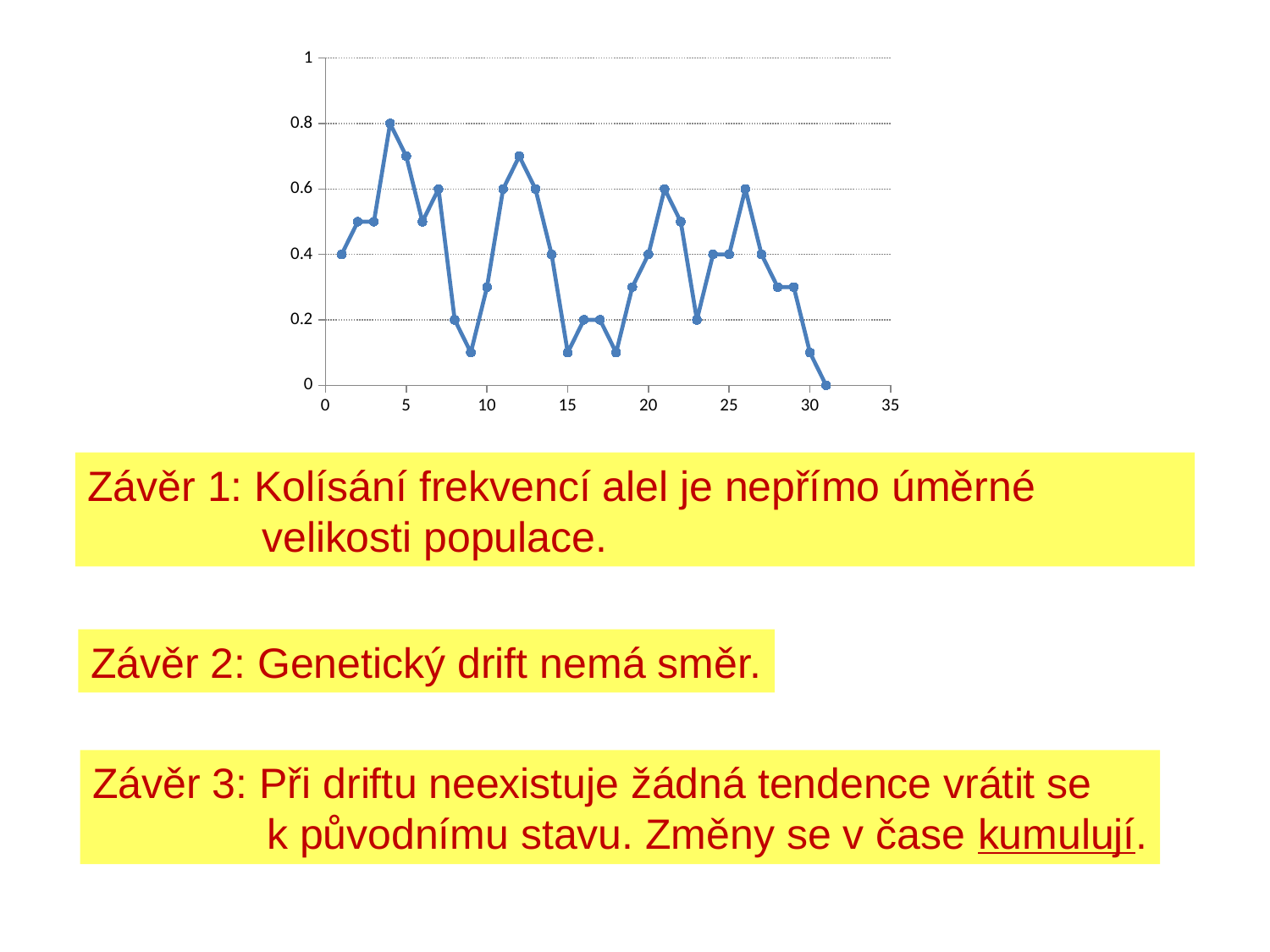
What is the difference between the value at x = 4 and the value at x = 8? 0.6 What colour is the plotted line? blue At which x value does the line reach its lowest point? 31 What is the value of the point at x = 8? 0.2 What is the value of the point at x = 1? 0.4 What kind of chart is shown on the slide? line chart Which is larger, the value at x = 4 or the value at x = 21? x = 4 At which x value does the line reach its highest point? 4 What is the value of the point at x = 31? 0 What is the value of the point at x = 4? 0.8 Is the value at x = 9 greater or less than 0.2? less Is the value at x = 12 greater or less than 0.6? greater